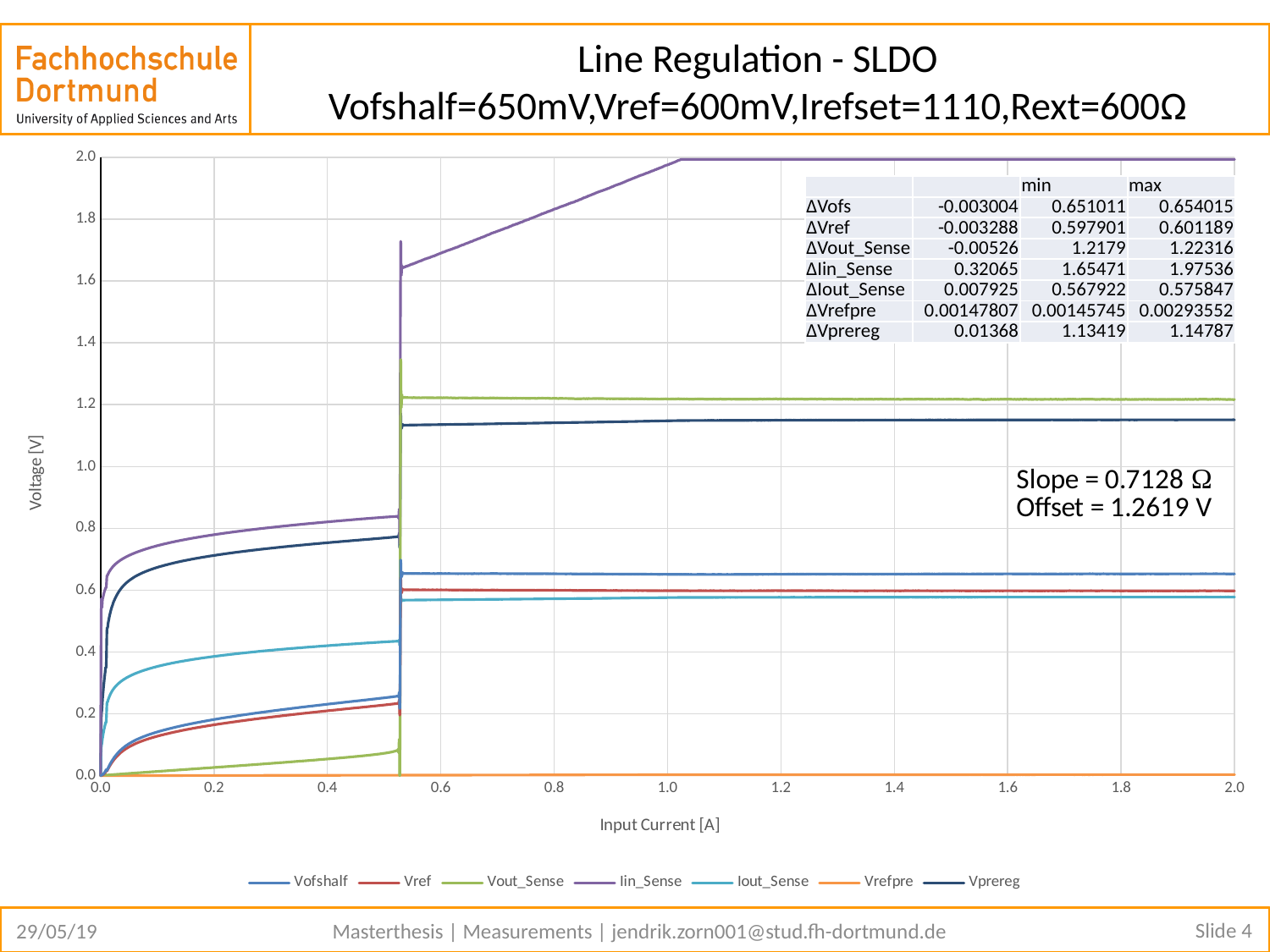
What is the label of the x axis? Input Current [A] In the table on the chart, what is the max value for ΔVout_Sense? 1.22316 In the table on the chart, what is the min value for ΔVref? 0.597901 What kind of chart is shown on the slide? line chart In the table on the chart, what is the min value for ΔVprereg? 1.13419 How many series does the legend list? 7 In the table on the chart, what is the max value for ΔVofs? 0.654015 Is the value of Iin_Sense at an input current of 1.5 A greater or less than 1.8? greater In the table on the chart, which row has the lowest max value? ΔVrefpre In the table on the chart, which row has the highest max value? ΔIin_Sense Is the value of Vrefpre at an input current of 1.0 A greater or less than 0.2? less What slope value is annotated on the chart? 0.7128 Ω